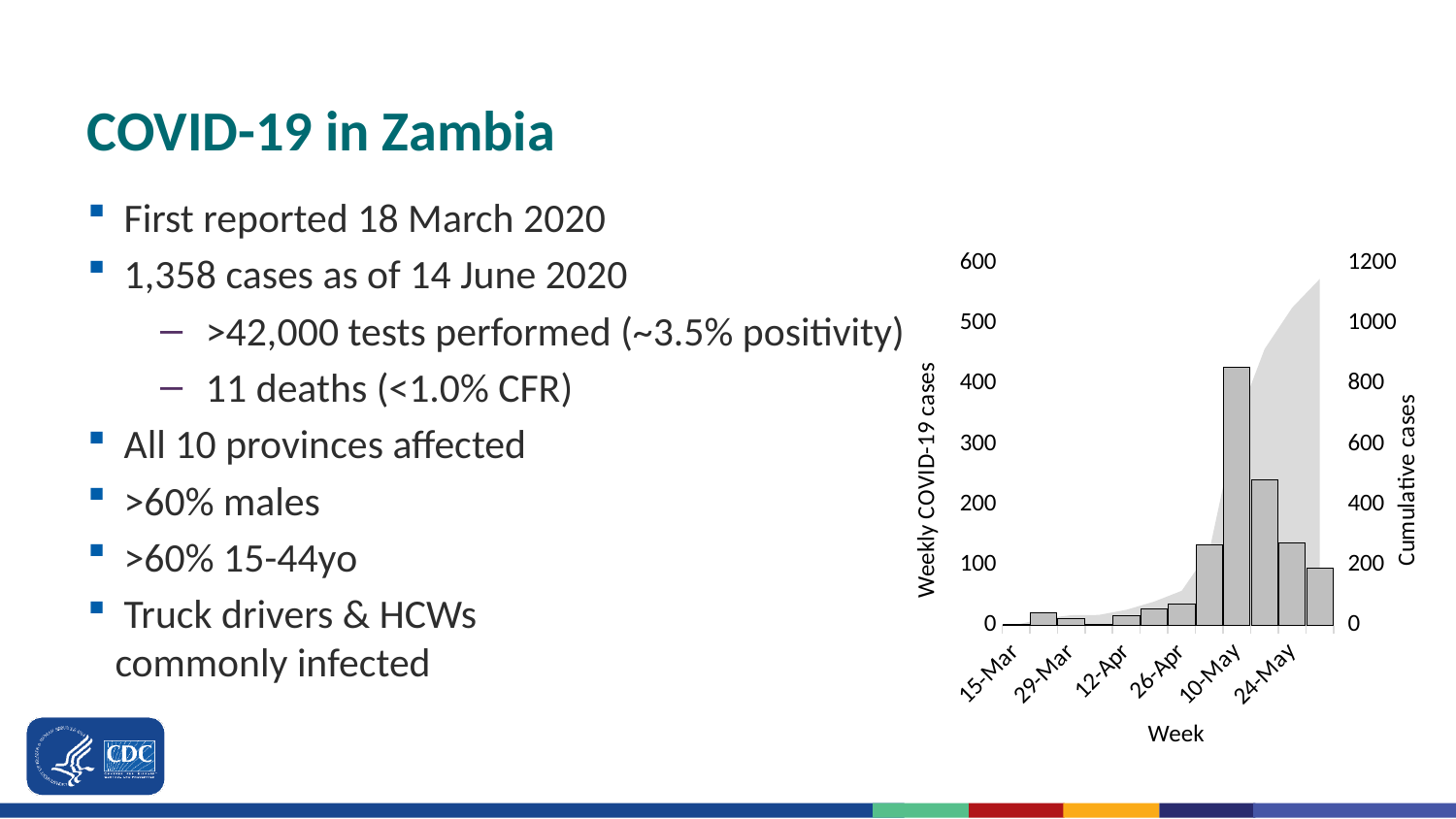
What is the title of the left vertical axis? Weekly COVID-19 cases What kind of chart is shown on the slide? combination bar and area chart Which week has more weekly COVID-19 cases, 10-May or 24-May? 10-May Do weekly COVID-19 cases rise or fall from 10-May to 24-May? fall What is the title of the right vertical axis? Cumulative cases Do weekly COVID-19 cases rise or fall from 15-Mar to 10-May? rise Is the value for weekly COVID-19 cases at 24-May greater or less than 200? less Is the cumulative cases value at the end of the series greater or less than 1000? greater Which week has more weekly COVID-19 cases, 26-Apr or 10-May? 10-May Which week has the highest number of weekly COVID-19 cases? 10-May Is the value for weekly COVID-19 cases at 15-Mar greater or less than 100? less